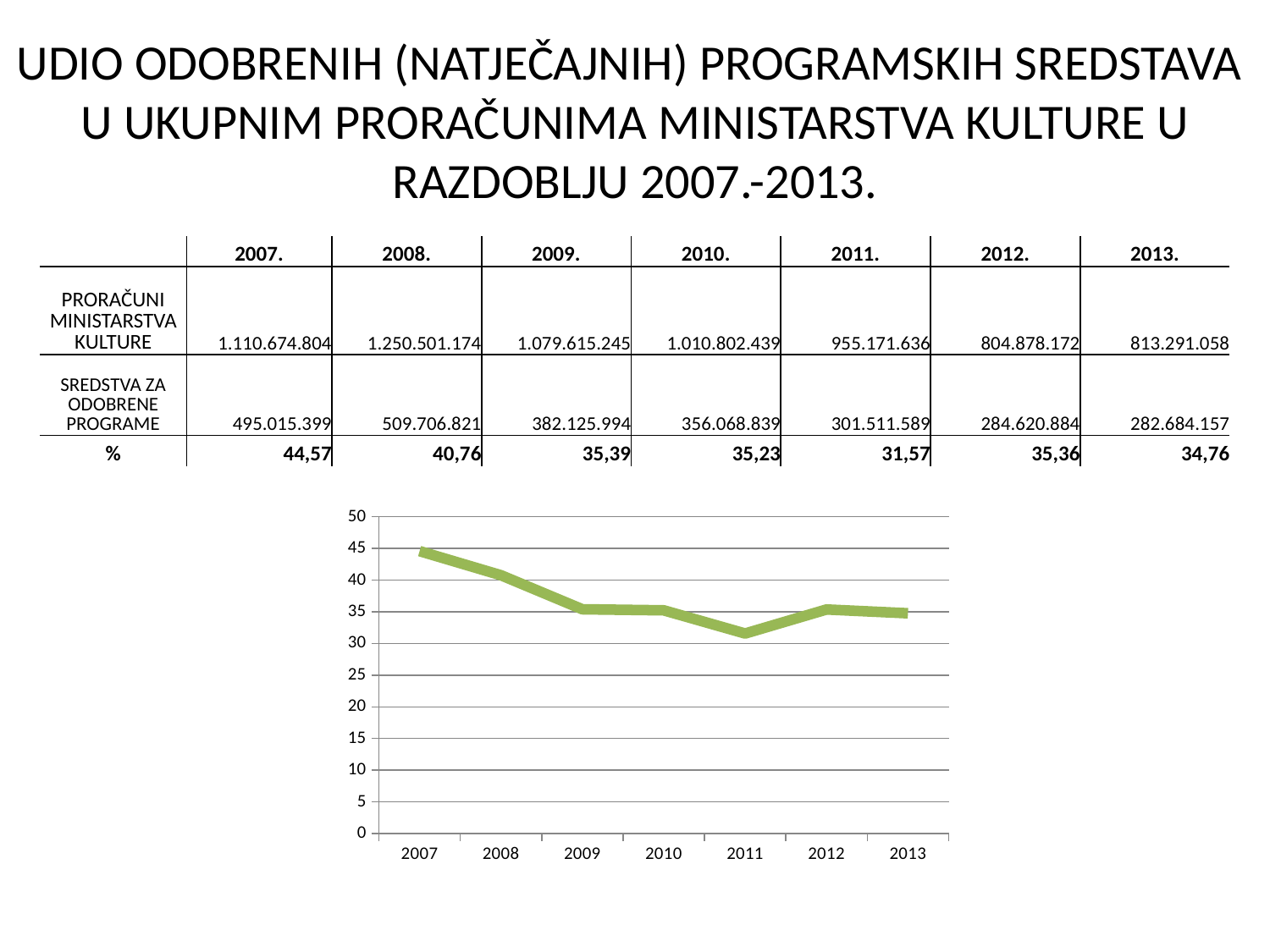
Which year has the lowest value on the line chart? 2011 According to the % row of the table, what is the share plotted for 2010? 35,23 Using the % values in the table, what is the difference between the 2007 value (44,57) and the 2011 value (31,57)? 13 How many years are plotted along the x axis of the line chart? 7 Which year has the highest value on the line chart? 2007 Which is larger on the line chart, the value for 2007 or the value for 2013? 2007 What kind of chart is shown on the slide? line chart Is the plotted value for 2011 greater or less than 30? greater Is the plotted value for 2011 greater or less than 35? less Which is larger on the line chart, the value for 2011 or the value for 2012? 2012 Does the plotted value rise or fall overall from 2007 to 2013? fall Is the plotted value for 2007 greater or less than 40? greater